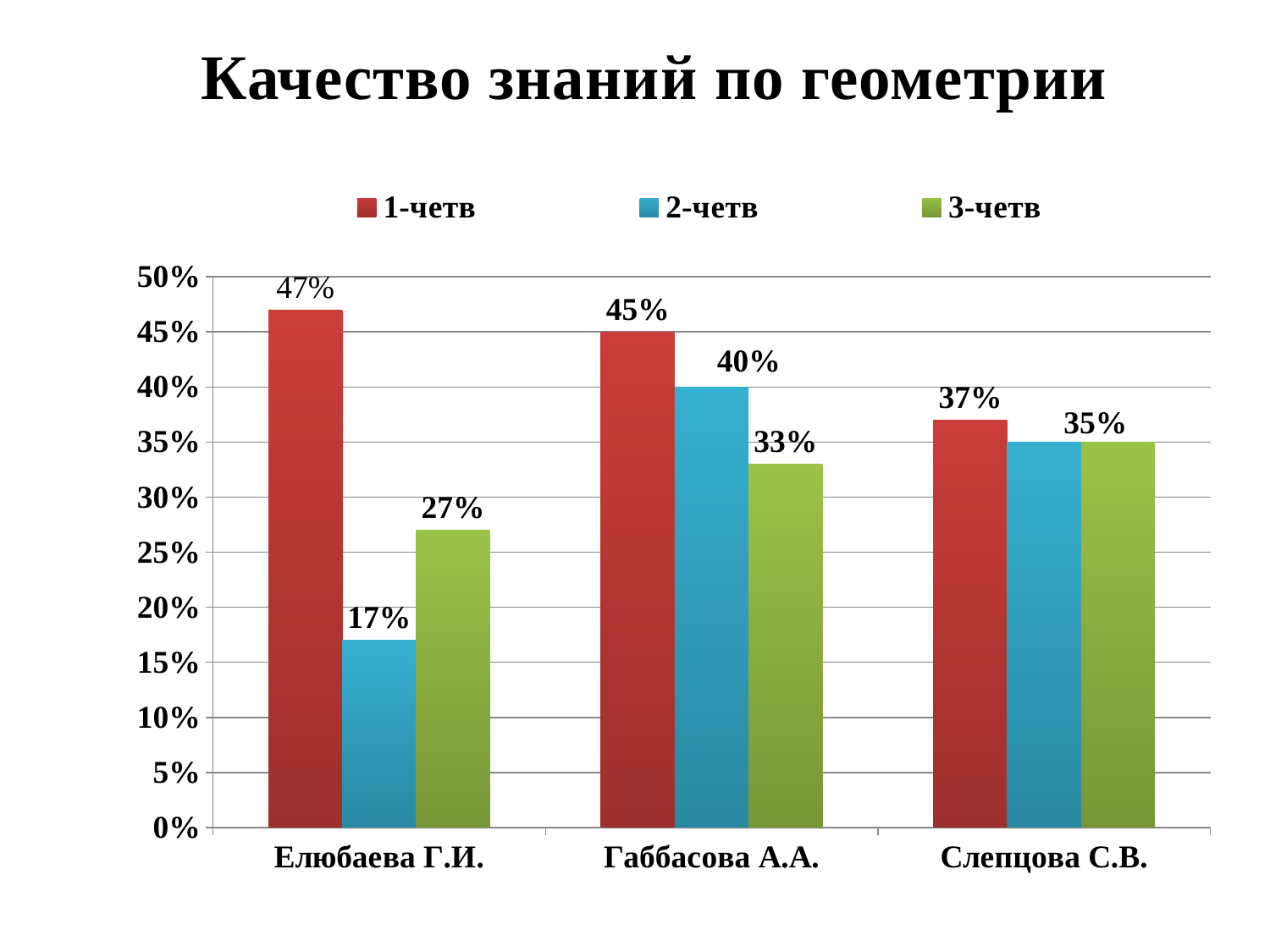
Which is larger for Габбасова А.А.: the 2-четв value or the 3-четв value? 2-четв What is the value for Елюбаева Г.И. in the 1-четв series? 47% What is the value for Слепцова С.В. in the 3-четв series? 35% What is the value for Габбасова А.А. in the 2-четв series? 40% What is the value for Елюбаева Г.И. in the 3-четв series? 27% Is the 2-четв value for Слепцова С.В. greater or less than 30%? greater What is the difference between the 1-четв and 2-четв values for Елюбаева Г.И.? 30% Which teacher has the highest value in the 1-четв series? Елюбаева Г.И. What kind of chart is shown on the slide? Bar chart Which teacher has the lowest value in the 2-четв series? Елюбаева Г.И. How many teachers (categories) are shown on the x axis? 3 How many series does the legend list? 3